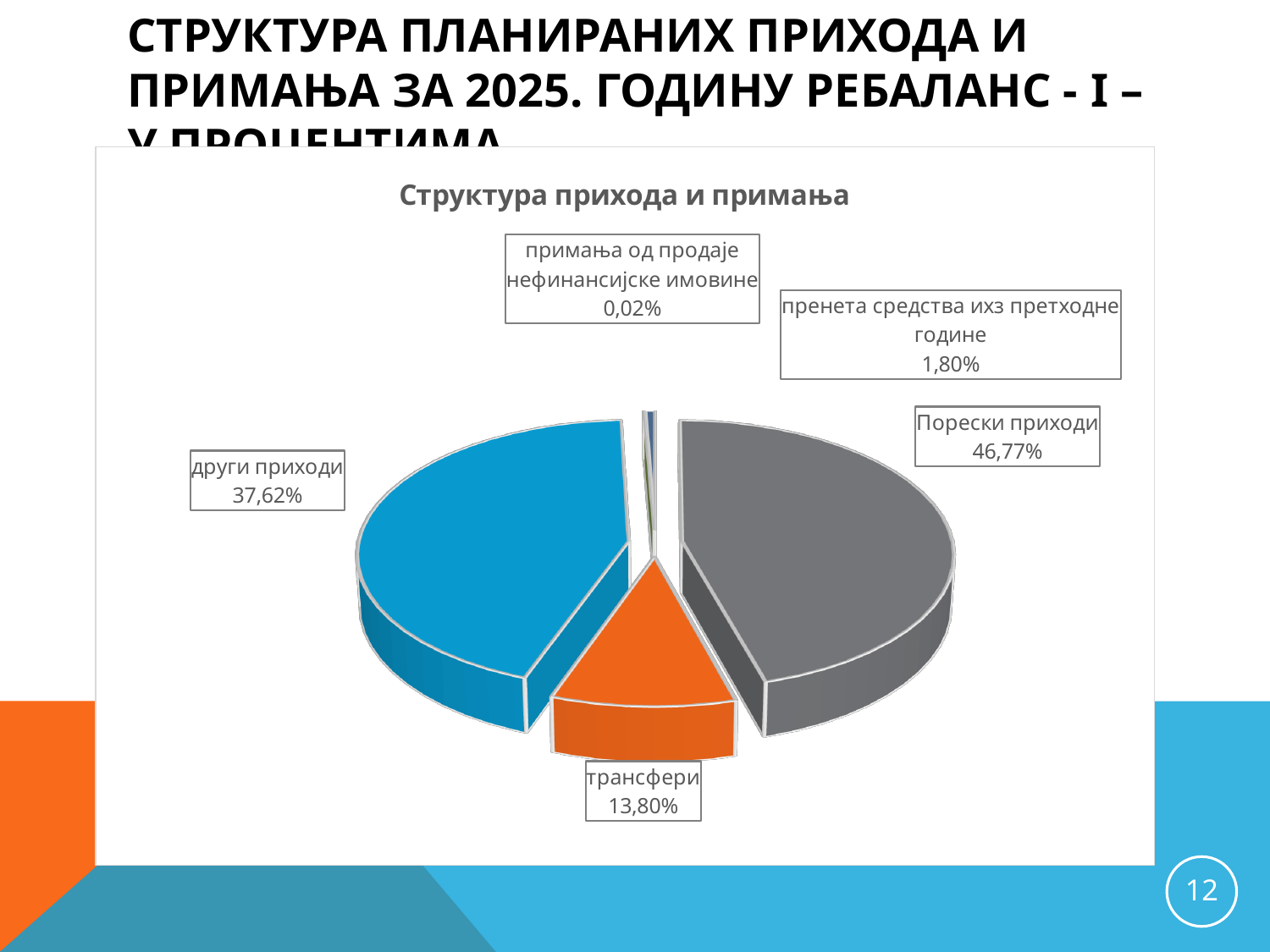
What share of the pie is labelled for Порески приходи? 46,77% What share of the pie is labelled for пренета средства ихз претходне године? 1,80% What is the difference in percentage points between Порески приходи and други приходи? 9,15 Which category has the largest share of the pie? Порески приходи Which category has the smallest share of the pie? примања од продаје нефинансијске имовине What share of the pie is labelled for други приходи? 37,62% What share of the pie is labelled for трансфери? 13,80% Which is larger, the share for трансфери or the share for пренета средства ихз претходне године? трансфери How many slices does the pie chart have? 5 What share of the pie is labelled for примања од продаје нефинансијске имовине? 0,02% What is the title of the chart? Структура прихода и примања What type of chart is shown on the slide? Pie chart